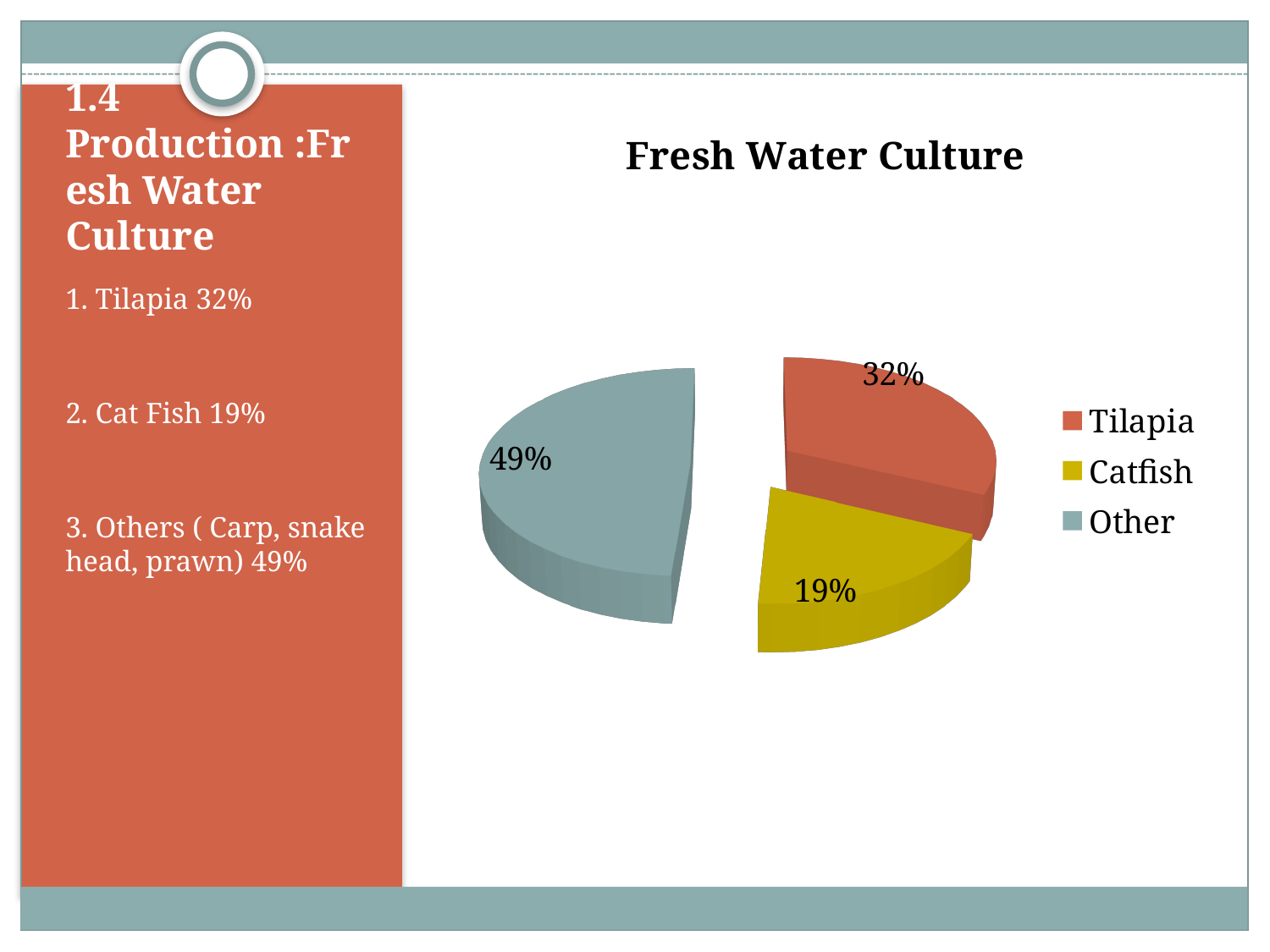
What kind of chart is shown on the slide? Pie chart What is the title of the chart? Fresh Water Culture Which category has the largest slice of the pie? Other What is the difference in percentage points between the Other slice and the Tilapia slice? 17 Which category has the smallest slice of the pie? Catfish What colour is the Catfish slice in the pie chart? Yellow What share of the pie does Tilapia represent? 32% What is the difference in percentage points between the Tilapia slice and the Catfish slice? 13 What share of the pie does Catfish represent? 19% What share of the pie does Other represent? 49% Which is larger, the Tilapia slice or the Catfish slice? Tilapia How many slices does the pie chart have? 3